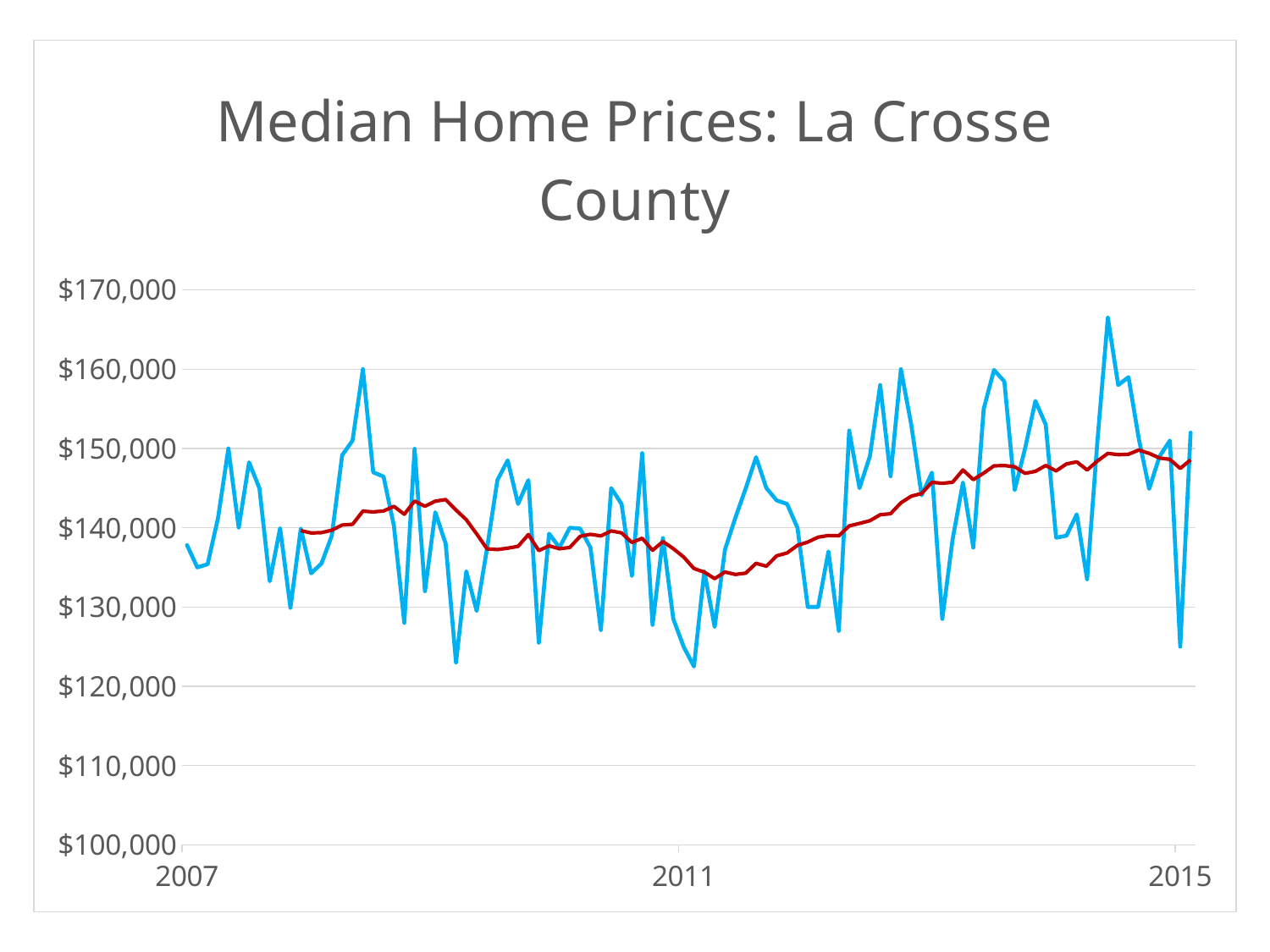
Is the value of the red line at 2015 greater or less than $140,000? greater How many lines are plotted on the chart? 2 What is the lowest value labelled on the vertical axis? $100,000 What type of chart is shown on the slide? line chart Is the lowest value reached by the blue line greater or less than $130,000? less Is the red line's value at 2015 higher or lower than its value at 2011? higher Is the blue line's peak near 2014 higher or lower than its peak near 2008? higher Is the highest value reached by the blue line greater or less than $160,000? greater What is the title of the chart? Median Home Prices: La Crosse County Does the red line rise or fall between 2011 and 2015? rise